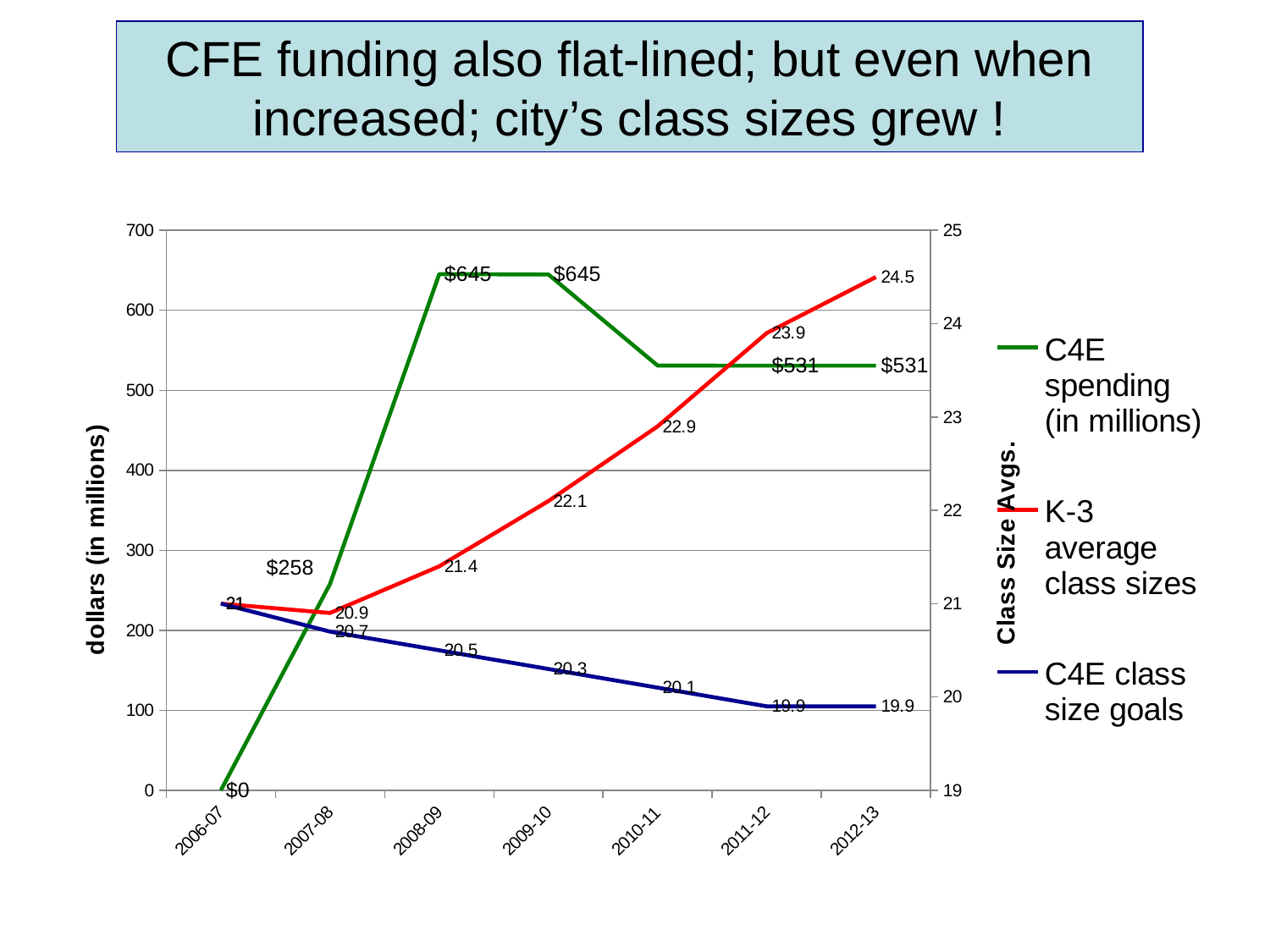
What was the C4E class size goal for 2009-10? 20.3 What type of chart is shown on the slide? line chart What is the difference between C4E spending in 2008-09 and in 2012-13? $114 How many school years are shown on the x axis? 7 In which school year was the K-3 average class size lowest? 2007-08 How many series does the legend list? 3 What was the K-3 average class size in 2012-13? 24.5 Does the K-3 average class size rise or fall from 2007-08 to 2012-13? rise Is C4E spending in 2010-11 greater or less than 500? greater Which is larger in 2011-12: the K-3 average class size or the C4E class size goal? K-3 average class size What was C4E spending (in millions) in 2008-09? $645 In which school year was C4E spending first at its highest value? 2008-09